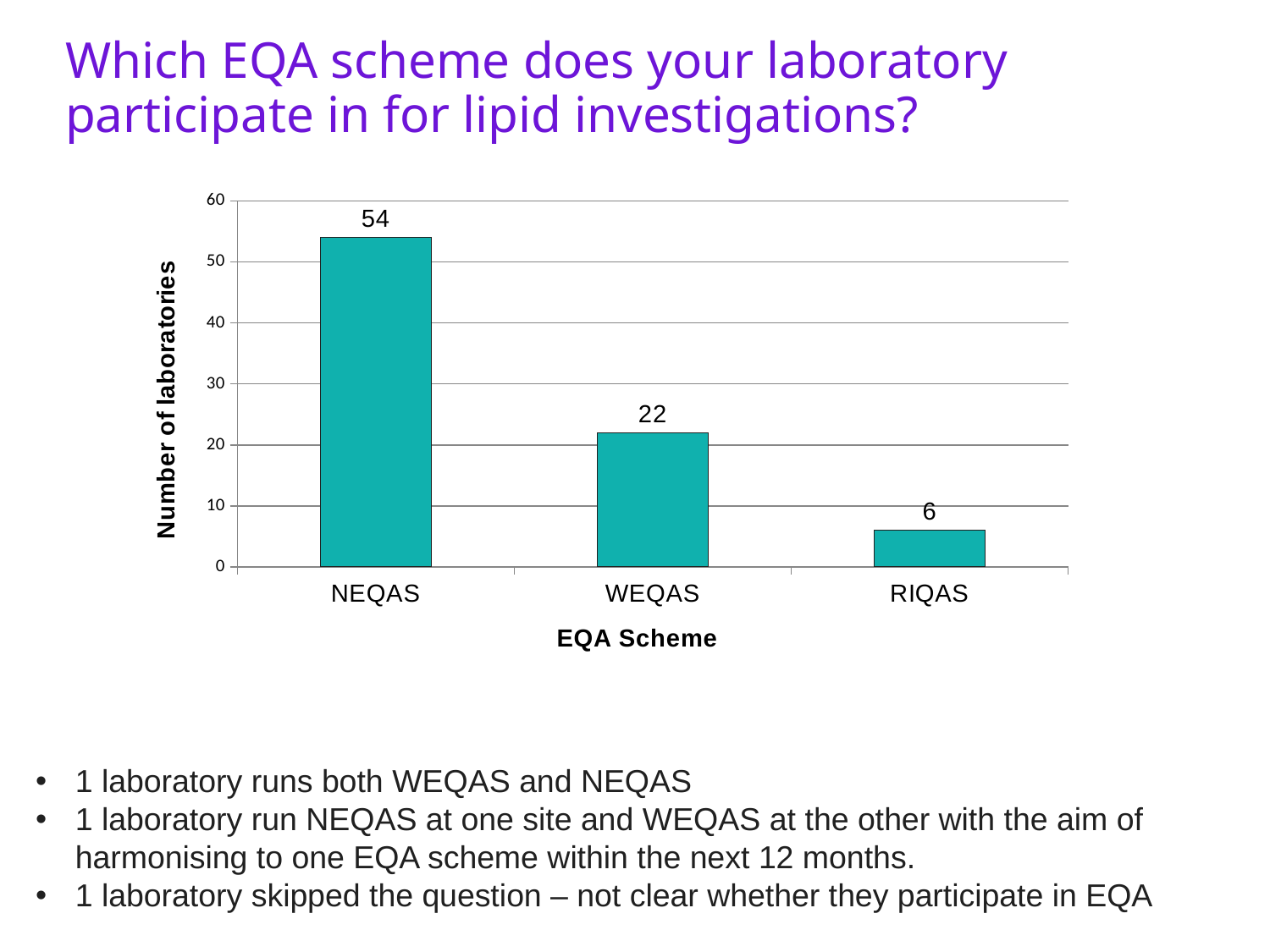
Is the value for NEQAS greater or less than 50? greater Which EQA scheme has the lowest number of laboratories? RIQAS Which has more laboratories, WEQAS or RIQAS? WEQAS What is the difference between the number of laboratories for NEQAS and WEQAS? 32 What kind of chart is shown on the slide? bar chart How many laboratories participate in WEQAS? 22 What is the label of the y axis? Number of laboratories Which EQA scheme has the highest number of laboratories? NEQAS What is the difference between the number of laboratories for WEQAS and RIQAS? 16 How many laboratories participate in RIQAS? 6 How many laboratories participate in NEQAS? 54 How many EQA schemes are shown on the x axis? 3